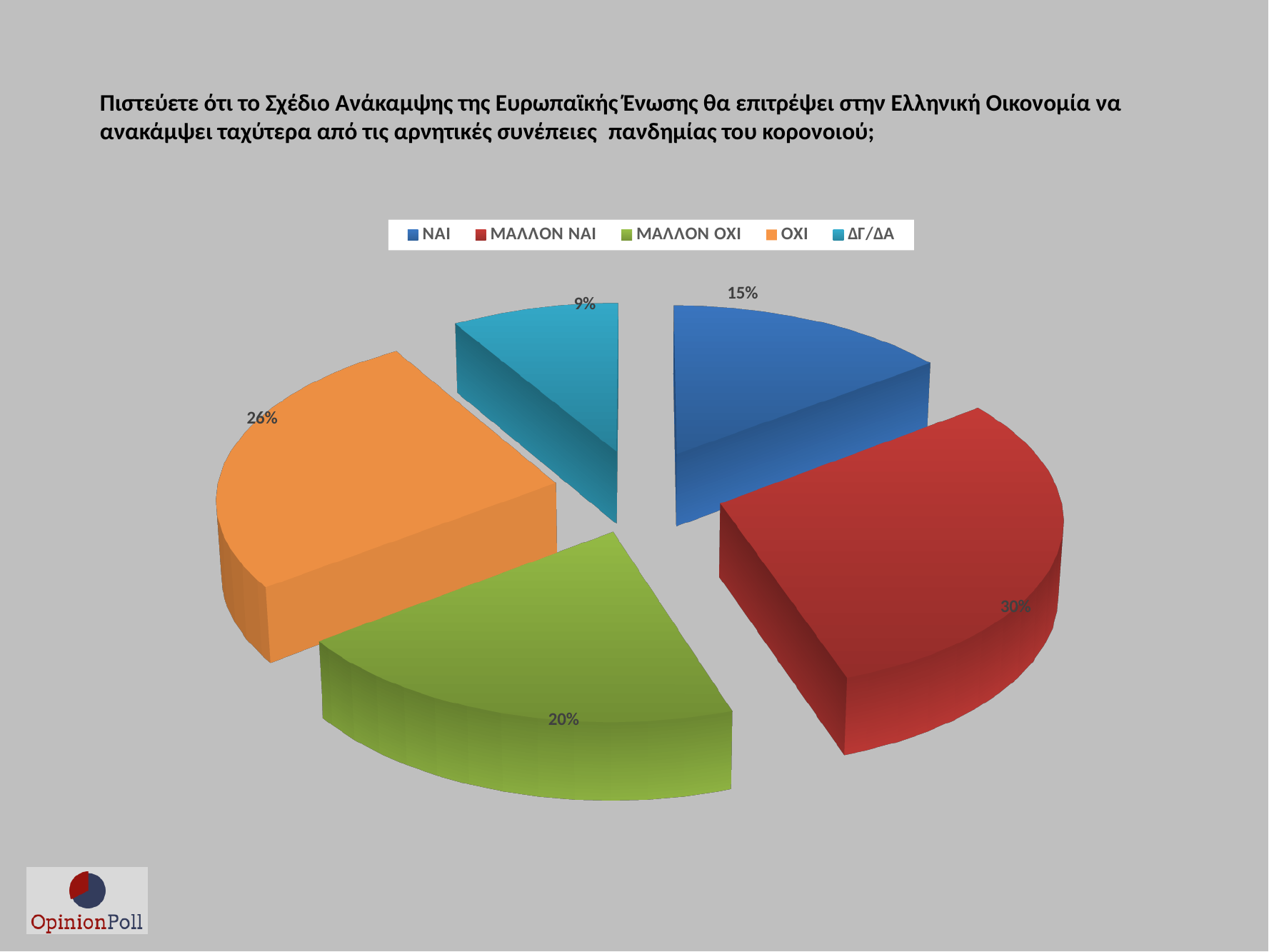
What percentage of respondents answered ΜΑΛΛΟΝ ΝΑΙ? 30% What colour is the slice for ΜΑΛΛΟΝ ΟΧΙ? Green Which response category has the largest share of the pie? ΜΑΛΛΟΝ ΝΑΙ What type of chart is shown on the slide? Pie chart What percentage of respondents answered ΝΑΙ? 15% What is the combined share of ΝΑΙ and ΜΑΛΛΟΝ ΝΑΙ? 45% How many slices does the pie chart have? 5 What percentage of respondents answered ΔΓ/ΔΑ? 9% What percentage of respondents answered ΟΧΙ? 26% Which is larger, the share for ΟΧΙ or the share for ΝΑΙ? ΟΧΙ What is the difference in percentage points between ΜΑΛΛΟΝ ΝΑΙ and ΜΑΛΛΟΝ ΟΧΙ? 10 Which response category has the smallest share of the pie? ΔΓ/ΔΑ